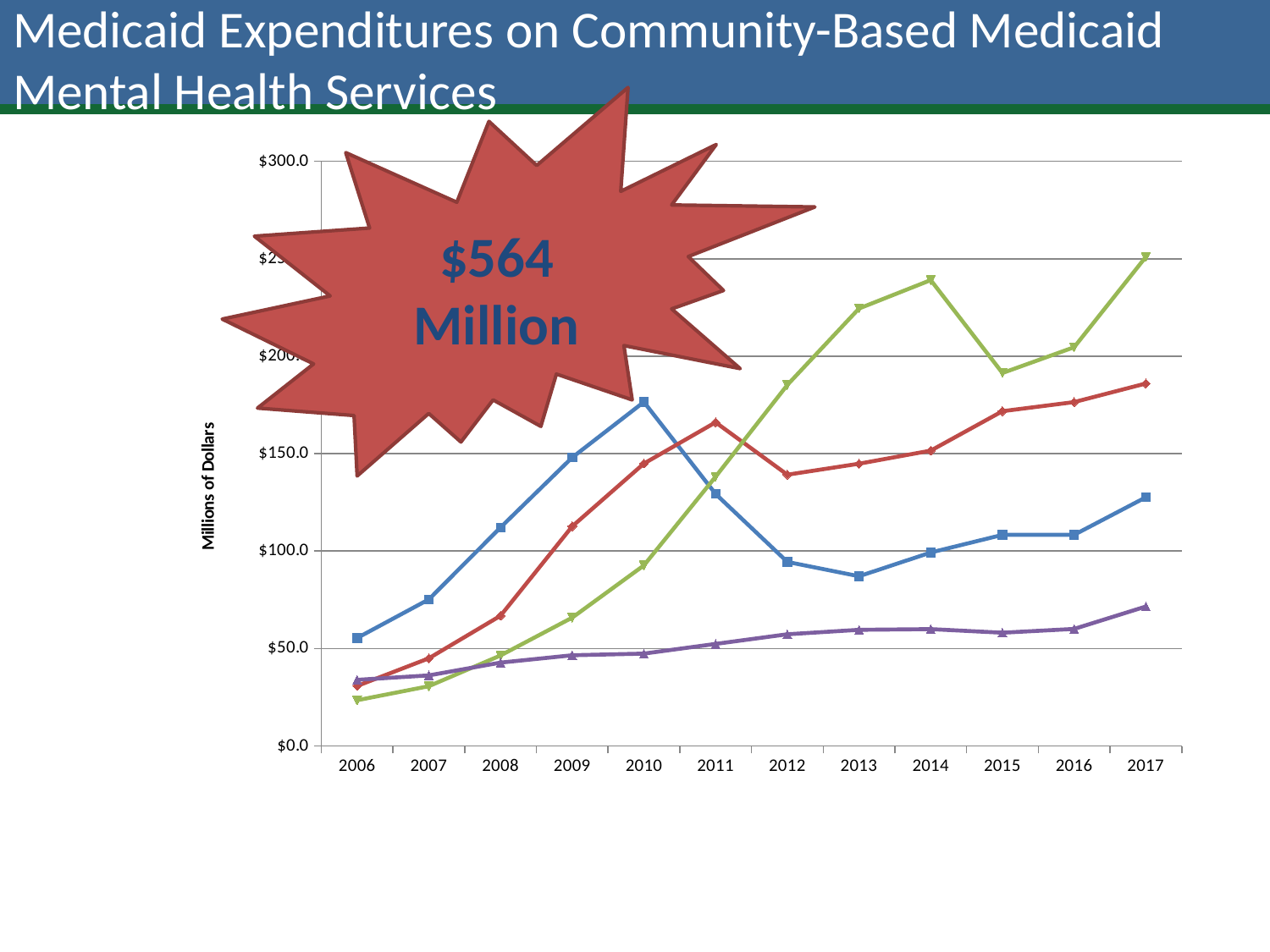
Is the value of the blue line in 2010 greater or less than $150.0? greater What text is written in the red starburst shape over the chart? $564 Million What is the title of the vertical axis of the chart? Millions of Dollars In which year does the blue line reach its highest value? 2010 What kind of chart is shown on the slide? line chart In which year is the green line at its lowest value? 2006 Does the purple line generally rise or fall from 2006 to 2017? rise Is the value of the green line in 2014 greater or less than $200.0? greater How many years are shown along the x axis of the chart? 12 Is the value of the purple line in 2006 greater or less than $50.0? less In 2010, which line has the higher value, the blue line or the red line? blue line